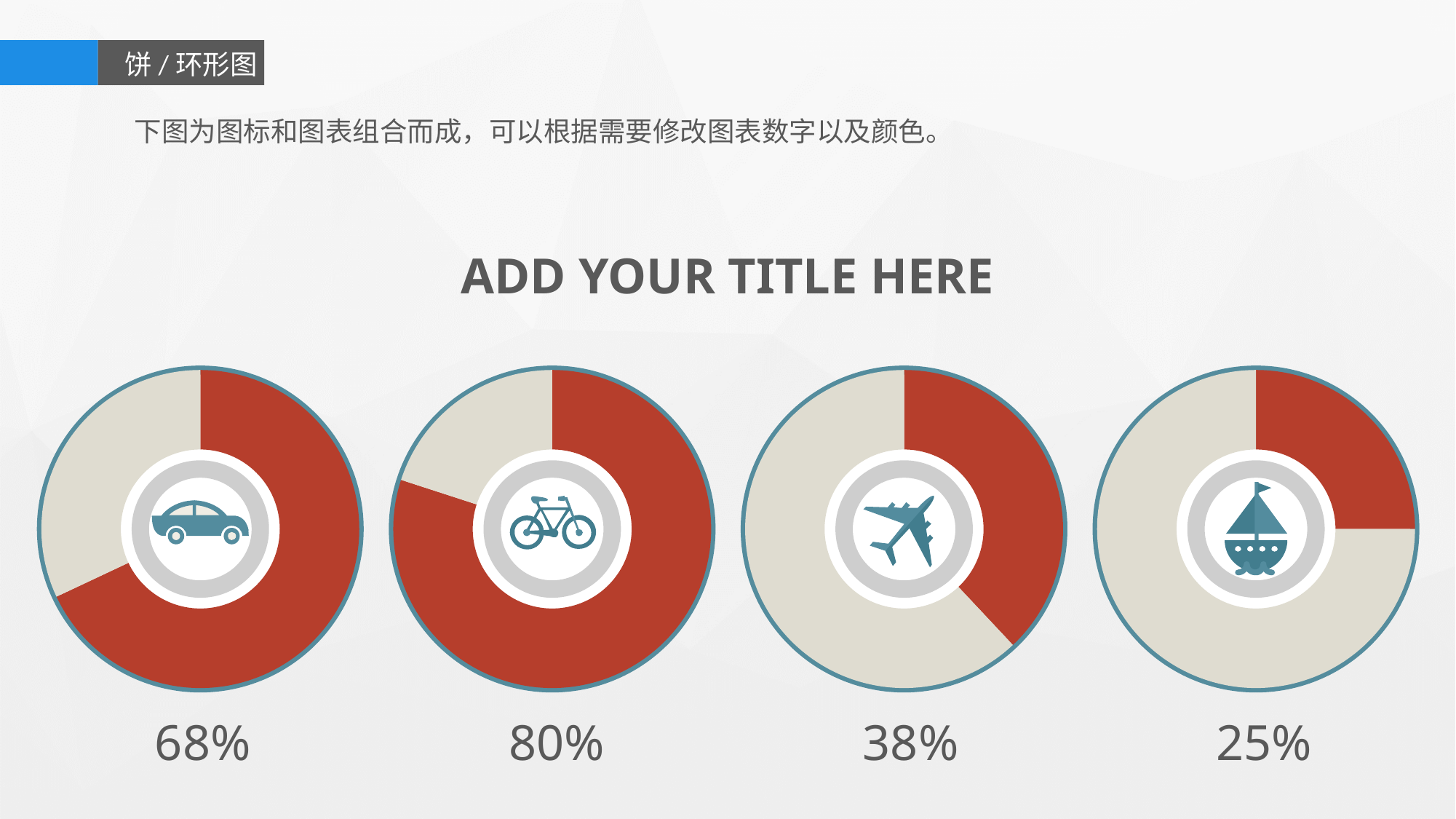
What percentage is shown below the chart with the car icon? 68% What percentage is shown below the chart with the bicycle icon? 80% How many circular charts are shown on the slide? 4 What percentage is shown below the chart with the boat icon? 25% Which icon's chart shows the lowest percentage? Boat Which is larger, the percentage for the car chart or the percentage for the airplane chart? Car What is the title text shown above the four charts? ADD YOUR TITLE HERE What is the difference between the percentage for the bicycle chart and the percentage for the car chart? 12% What percentage is shown below the chart with the airplane icon? 38% What is the difference between the percentage for the airplane chart and the percentage for the boat chart? 13% What kind of chart is used for each of the four figures on the slide? Doughnut chart Which icon's chart shows the highest percentage? Bicycle